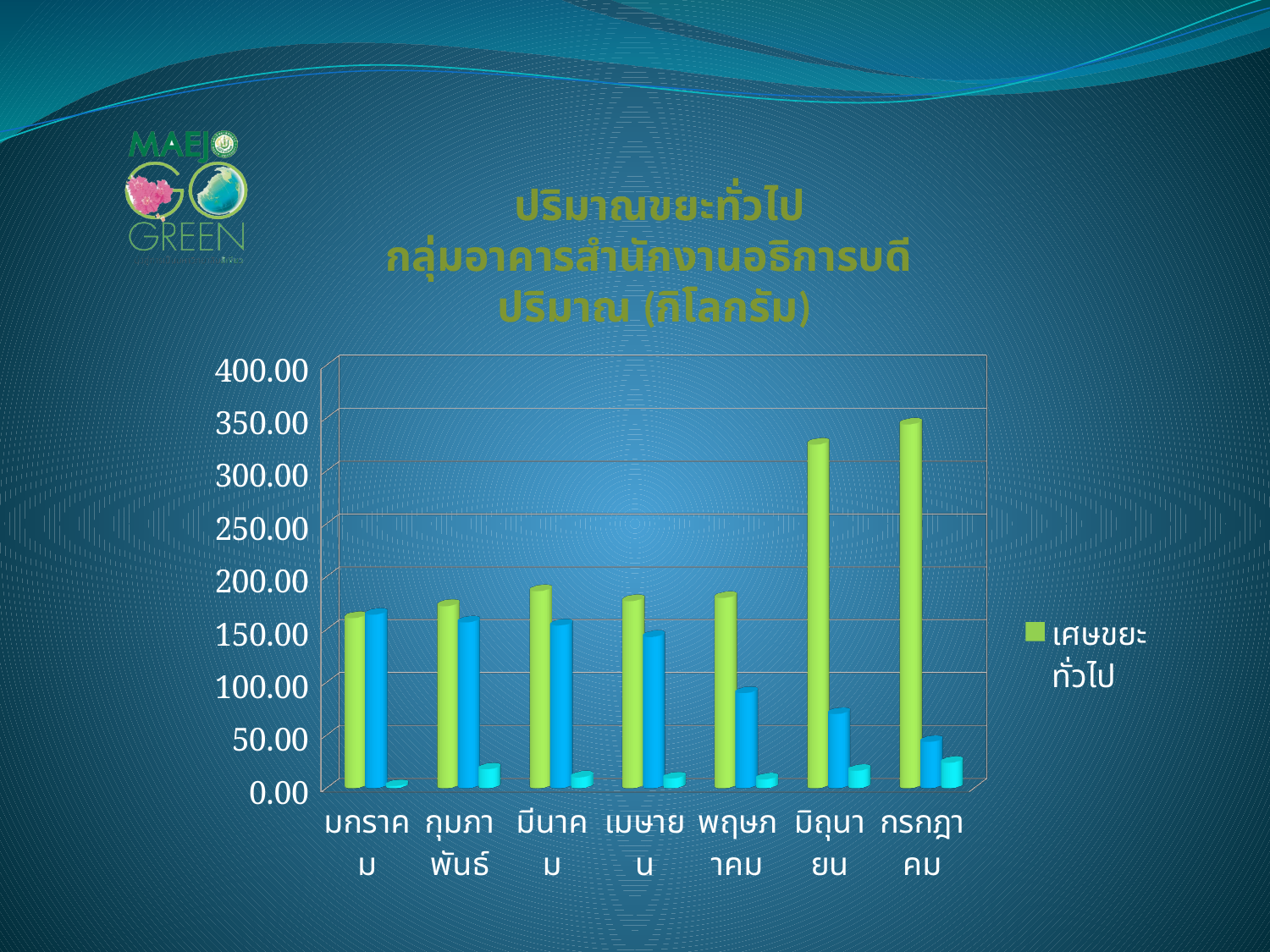
Which month has the shortest blue bar? กรกฎาคม How many month categories are shown on the x axis? 7 Which month has the shortest green bar? มกราคม Do the blue bars rise or fall from มกราคม to กรกฎาคม? fall Is the green bar for มีนาคม greater or less than 200.00? less Is the green bar for กรกฎาคม greater or less than 300.00? greater What is the highest value shown on the y axis? 400.00 What kind of chart is shown on the slide? bar chart In มิถุนายน, which is larger, the green bar or the blue bar? the green bar Which month has the tallest green bar? กรกฎาคม Is the green bar for มิถุนายน greater or less than 300.00? greater